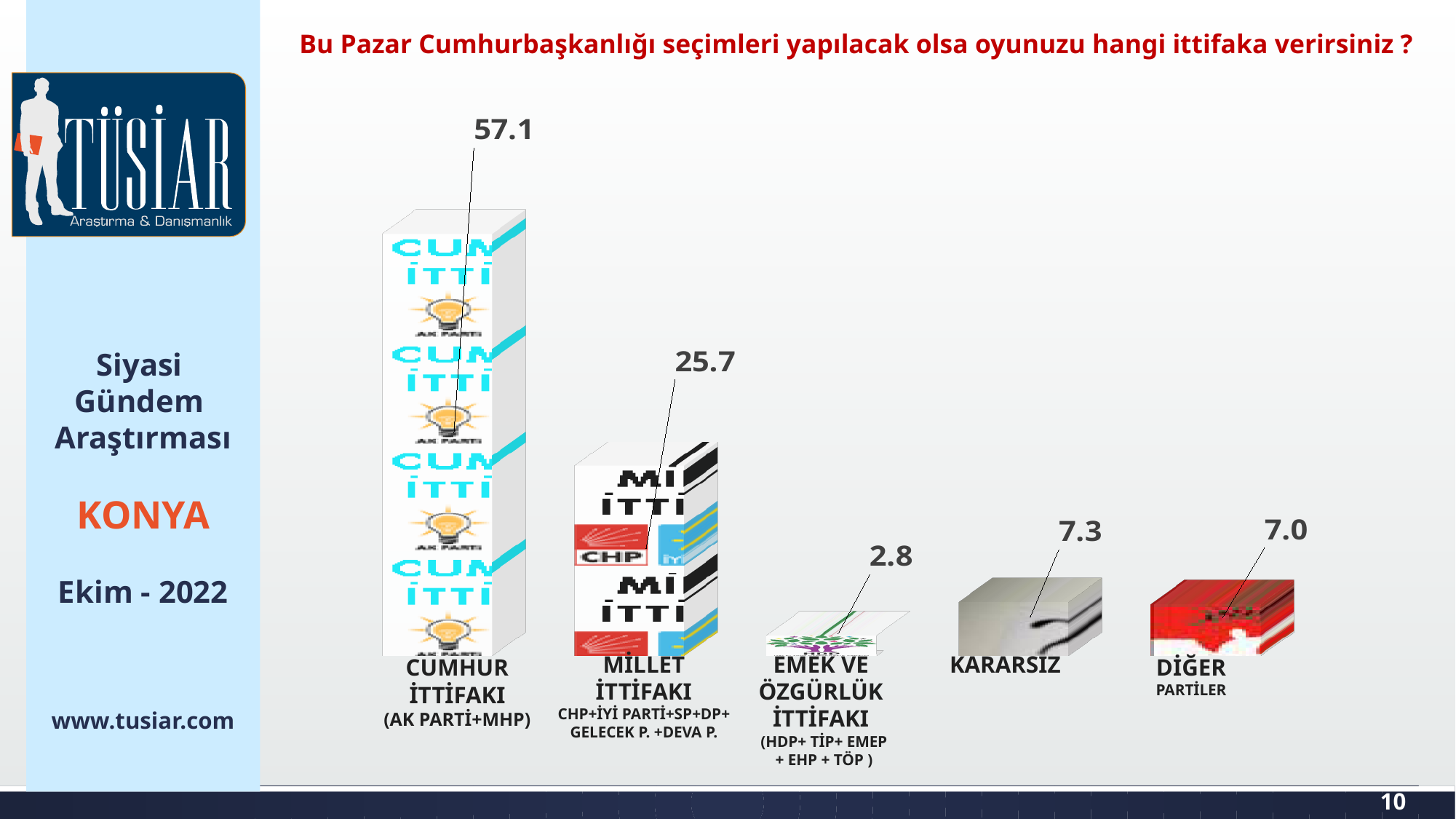
What is the value for CUMHUR İTTİFAKI? 57.1 Which category has the highest value? CUMHUR İTTİFAKI What kind of chart is shown on the slide? Bar chart Which category has the lowest value? EMEK VE ÖZGÜRLÜK İTTİFAKI What is the value for DİĞER PARTİLER? 7.0 What is the value for KARARSIZ? 7.3 How many categories are shown in the chart? 5 Which is larger, the value for KARARSIZ or the value for DİĞER PARTİLER? KARARSIZ What is the value for EMEK VE ÖZGÜRLÜK İTTİFAKI? 2.8 What is the value for MİLLET İTTİFAKI? 25.7 What is the difference between the values for CUMHUR İTTİFAKI and MİLLET İTTİFAKI? 31.4 Which city is this survey about, according to the slide? KONYA